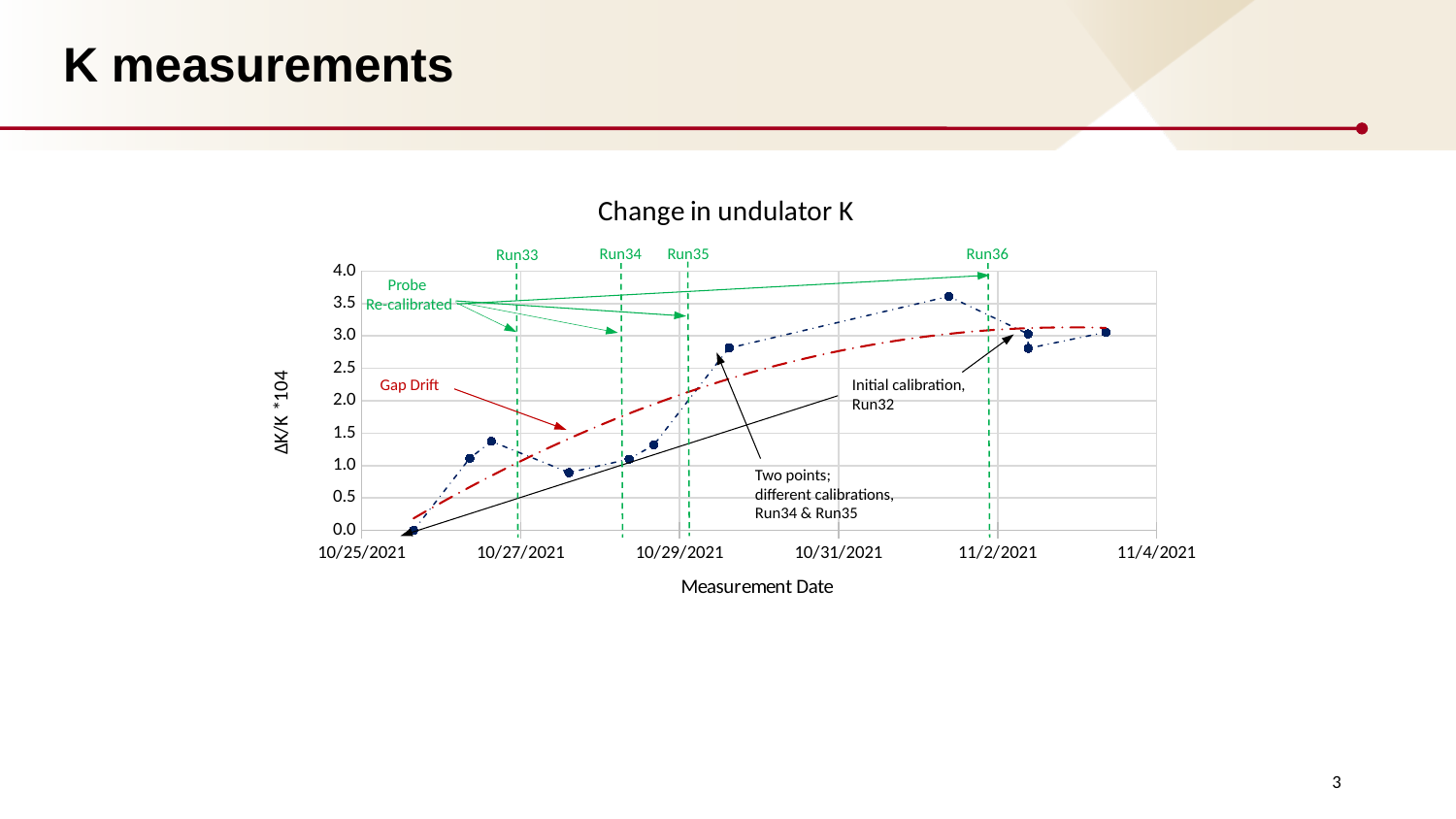
How many run labels (Run33, Run34, etc.) mark vertical dashed lines on the chart? 4 What is the highest value shown on the y axis? 4.0 What is the latest date shown on the x axis? 11/4/2021 Is the value of the plotted point just before 10/27/2021 greater or less than 2.0? less What is the title of the chart? Change in undulator K Which is larger: the plotted value at the initial calibration (Run32) or the plotted value just before Run36? the value just before Run36 What is the label of the x axis? Measurement Date Overall, do the plotted ΔK/K values rise or fall from 10/25/2021 to 11/4/2021? rise What is the earliest date shown on the x axis? 10/25/2021 What kind of chart is shown on the slide? line chart Is the value of the highest plotted point, just before Run36, greater or less than 3.0? greater Is the value of the first plotted point, at the initial calibration (Run32), greater or less than 0.5? less